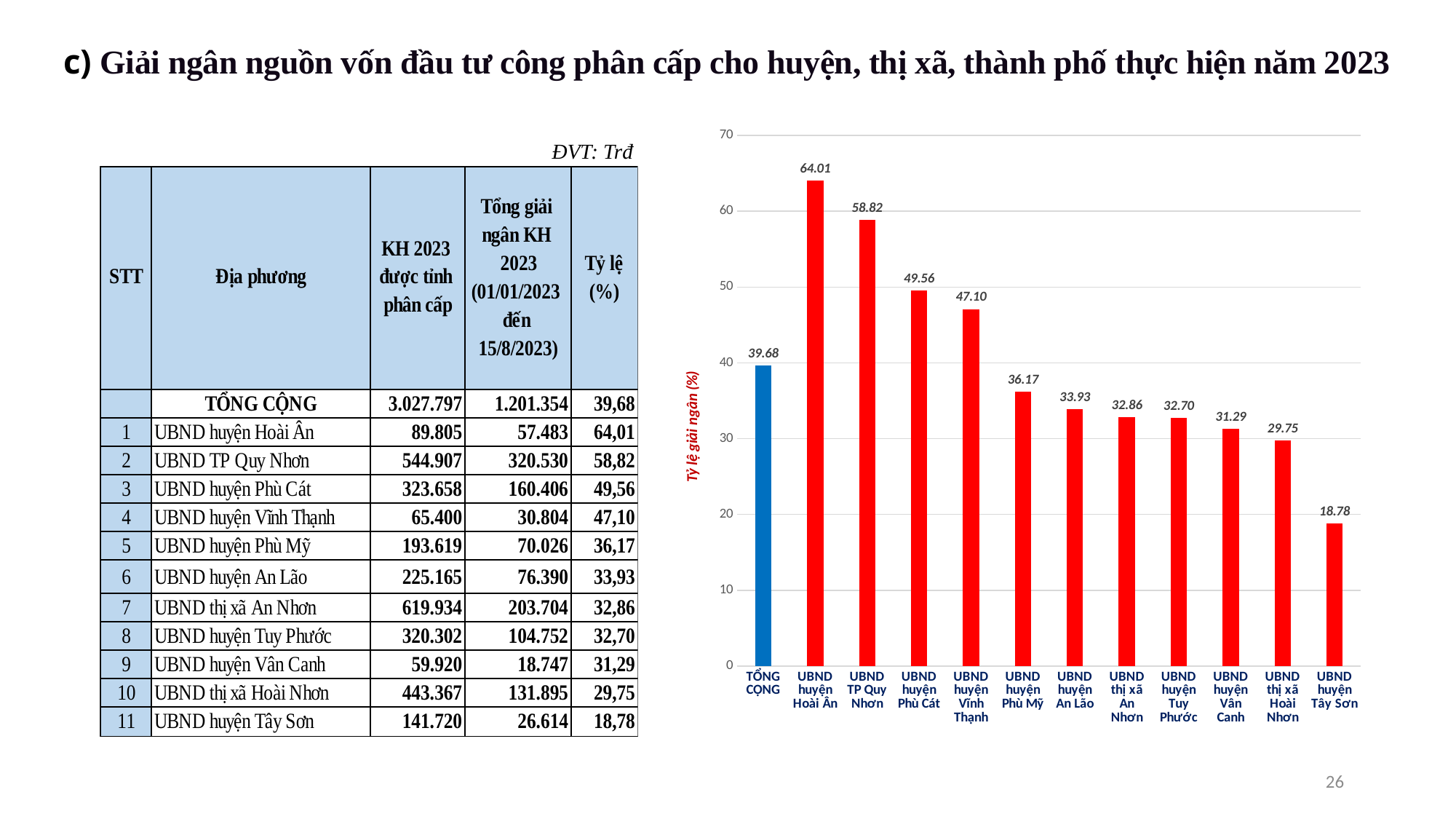
What is the value for UBND huyện Hoài Ân in the chart? 64.01 What is the title of the vertical axis of the chart? Tỷ lệ giải ngân (%) Which category has the highest value in the chart? UBND huyện Hoài Ân What is the difference between the values for UBND huyện Hoài Ân and UBND TP Quy Nhơn? 5.19 Do the values of the red bars rise or fall from left to right along the x axis? Fall Which category has the lowest value in the chart? UBND huyện Tây Sơn What type of chart is shown on the slide? Bar chart What is the value for UBND TP Quy Nhơn in the chart? 58.82 Which is larger, the value for UBND huyện Phù Cát or UBND huyện Vĩnh Thạnh? UBND huyện Phù Cát What is the value for UBND huyện Tây Sơn in the chart? 18.78 How many bars are plotted in the chart? 12 What is the value for TỔNG CỘNG in the chart? 39.68